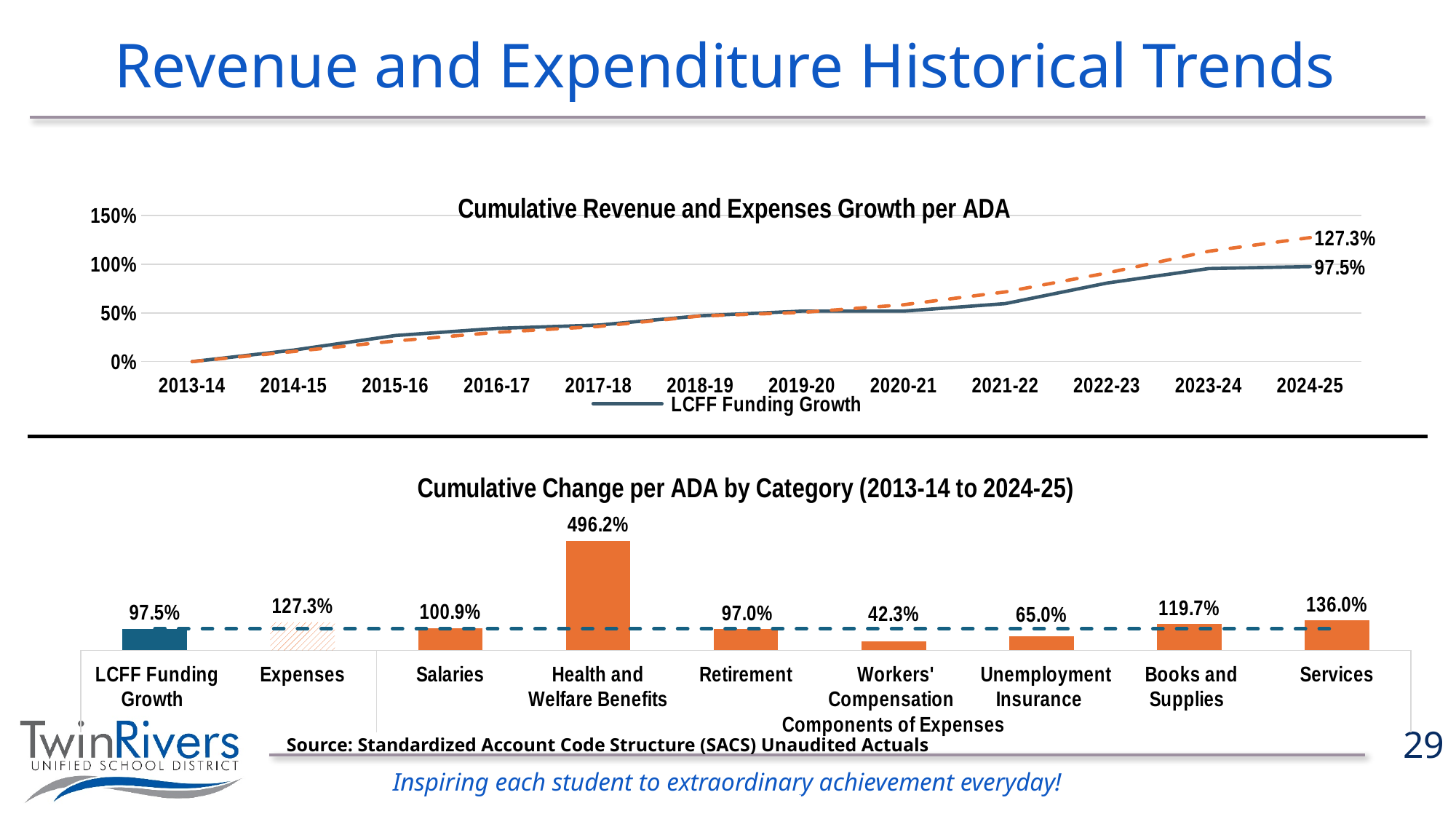
In the 'Cumulative Change per ADA by Category (2013-14 to 2024-25)' chart, what is the value for Workers' Compensation? 42.3% In the 'Cumulative Change per ADA by Category (2013-14 to 2024-25)' chart, which category has the highest value? Health and Welfare Benefits How many categories are shown in the 'Cumulative Change per ADA by Category (2013-14 to 2024-25)' chart? 9 In the 'Cumulative Change per ADA by Category (2013-14 to 2024-25)' chart, what is the value for Health and Welfare Benefits? 496.2% In the 'Cumulative Change per ADA by Category (2013-14 to 2024-25)' chart, what is the difference between the values for Services and Books and Supplies? 16.3% In the 'Cumulative Change per ADA by Category (2013-14 to 2024-25)' chart, which category has the lowest value? Workers' Compensation In the 'Cumulative Change per ADA by Category (2013-14 to 2024-25)' chart, which is larger, Salaries or Retirement? Salaries What kind of chart is the 'Cumulative Change per ADA by Category (2013-14 to 2024-25)' chart? Bar chart In the 'Cumulative Revenue and Expenses Growth per ADA' chart, what is the value of LCFF Funding Growth in 2024-25? 97.5% What kind of chart is the 'Cumulative Revenue and Expenses Growth per ADA' chart? Line chart In the 'Cumulative Revenue and Expenses Growth per ADA' chart, is the value of LCFF Funding Growth in 2021-22 greater or less than 100%? less In the 'Cumulative Revenue and Expenses Growth per ADA' chart, does LCFF Funding Growth rise or fall from 2013-14 to 2024-25? Rise